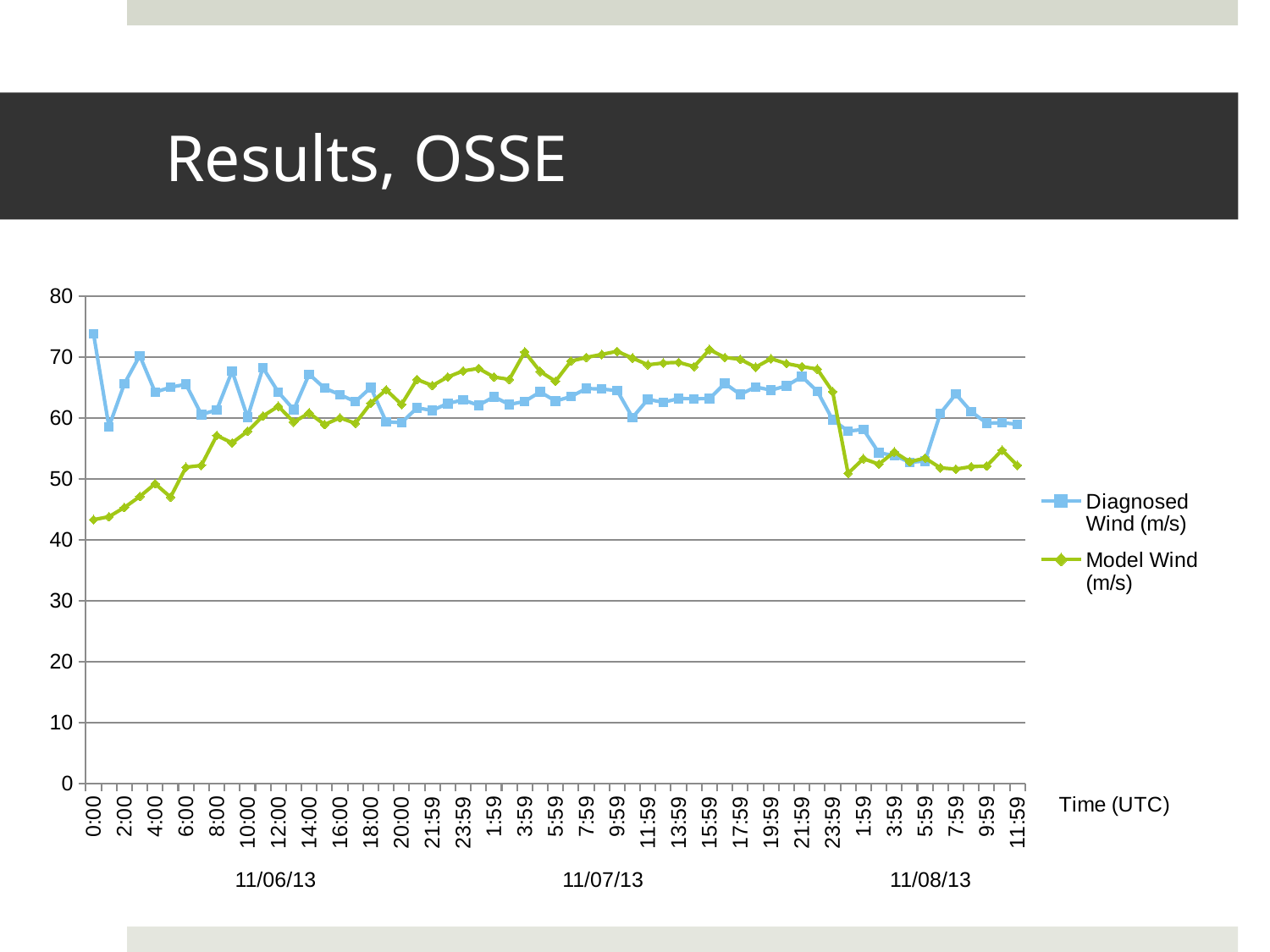
Which series reaches the lowest value anywhere on the chart? Model Wind (m/s) At 7:59 on 11/08/13, which series has the higher value, Diagnosed Wind or Model Wind? Diagnosed Wind How many series does the legend list? 2 Is the Diagnosed Wind value at 0:00 on 11/06/13 greater or less than 70? greater Does the Model Wind series rise or fall between 0:00 and 12:00 on 11/06/13? rise At 9:59 on 11/07/13, which series has the higher value, Diagnosed Wind or Model Wind? Model Wind Is the Model Wind value at 0:00 on 11/06/13 greater or less than 50? less Is the Diagnosed Wind value at 1:59 on 11/08/13 greater or less than 60? less What are the two series named in the legend? Diagnosed Wind (m/s) and Model Wind (m/s) What kind of chart is shown on the slide? line chart What is the title of the x axis? Time (UTC) At 0:00 on 11/06/13, which series has the higher value, Diagnosed Wind or Model Wind? Diagnosed Wind